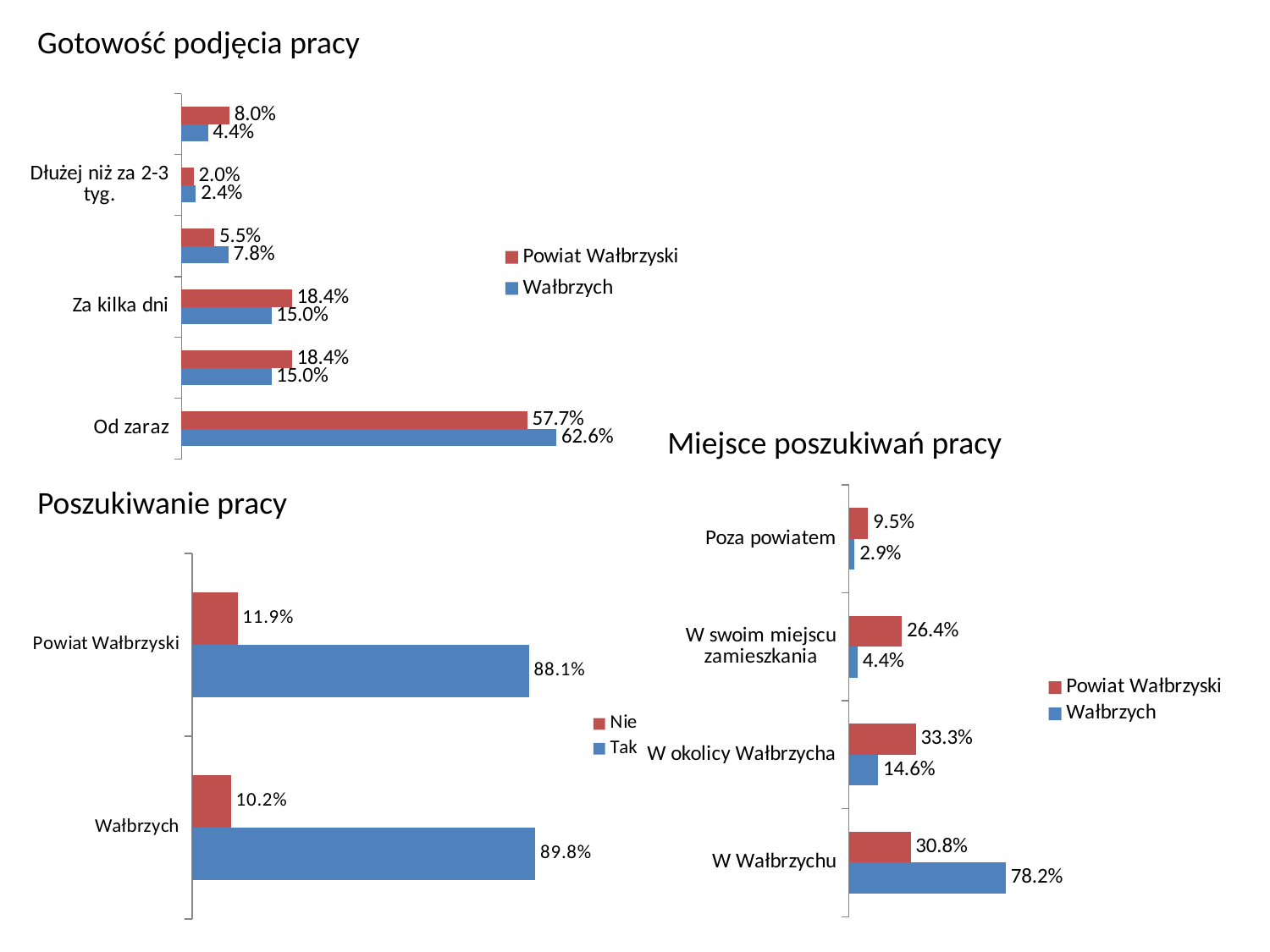
How many series does the legend of the 'Gotowość podjęcia pracy' chart list? 2 In the 'Poszukiwanie pracy' chart, which is larger: the 'Tak' value for Wałbrzych or the 'Tak' value for Powiat Wałbrzyski? Wałbrzych In the 'Gotowość podjęcia pracy' chart, what is the difference between the Wałbrzych and Powiat Wałbrzyski values for 'Od zaraz'? 4.9% How many categories are shown in the 'Miejsce poszukiwań pracy' chart? 4 In the 'Poszukiwanie pracy' chart, what is the 'Tak' value for Wałbrzych? 89.8% In the 'Miejsce poszukiwań pracy' chart, which category has the highest value for Powiat Wałbrzyski? W okolicy Wałbrzycha In the 'Od zaraz' category of the 'Gotowość podjęcia pracy' chart, what is the value for Wałbrzych? 62.6% In the 'Miejsce poszukiwań pracy' chart, what is the Wałbrzych value for 'W Wałbrzychu'? 78.2% In the 'Poszukiwanie pracy' chart, what is the 'Nie' value for Powiat Wałbrzyski? 11.9% In the 'Od zaraz' category of the 'Gotowość podjęcia pracy' chart, what is the value for Powiat Wałbrzyski? 57.7% What kind of chart is 'Poszukiwanie pracy'? Bar chart In the 'Miejsce poszukiwań pracy' chart, which category has the lowest value for Wałbrzych? Poza powiatem